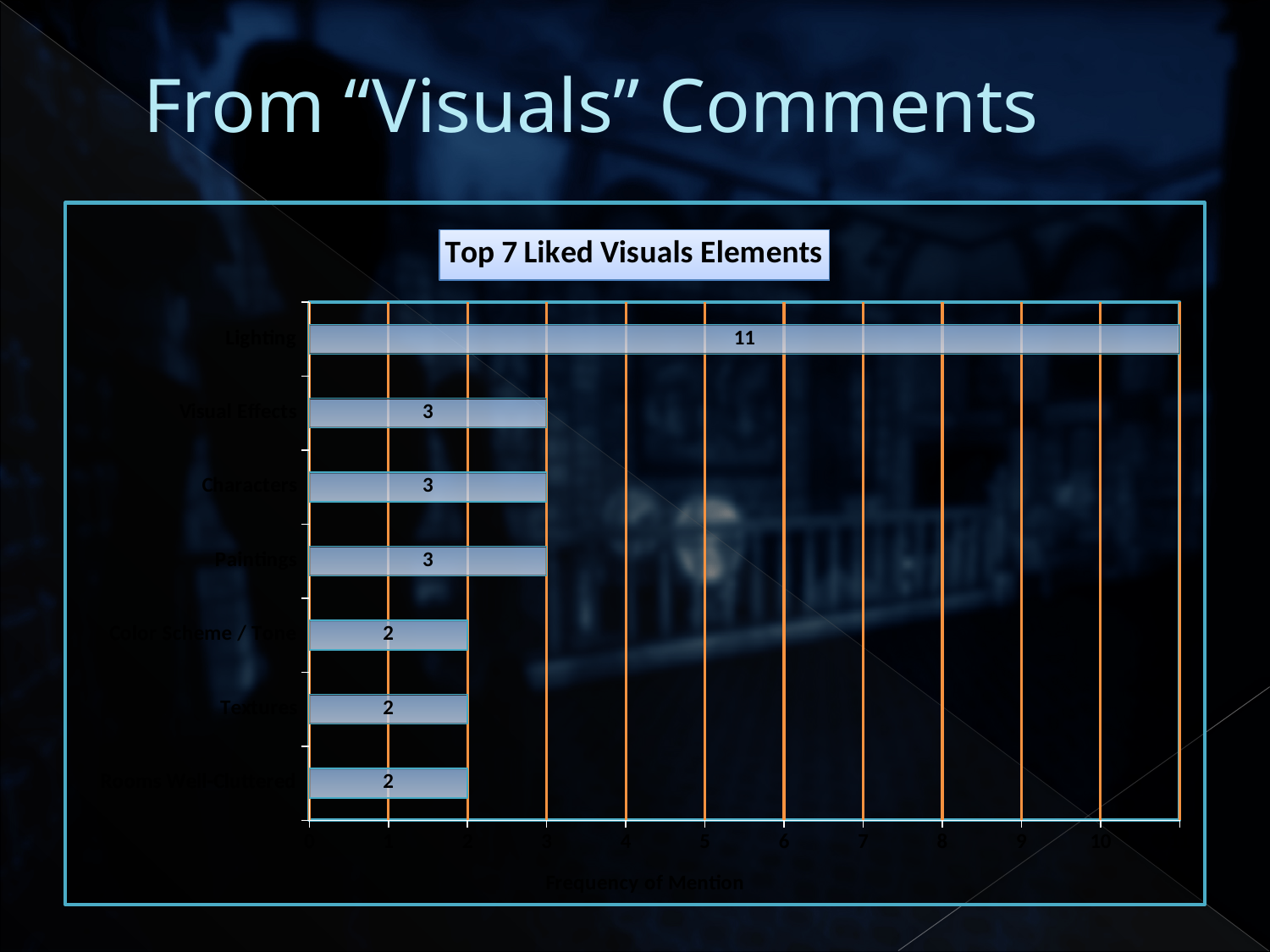
What is the value for Lighting? 11 What is the label of the horizontal axis? Frequency of Mention Which category has the highest frequency of mention? Lighting What is the title of the chart? Top 7 Liked Visuals Elements What is the value for Textures? 2 How many categories are shown in the chart? 7 Is the value for Lighting greater or less than 10? greater What kind of chart is shown on the slide? Bar chart Which is larger, the value for Visual Effects or the value for Color Scheme / Tone? Visual Effects What is the value for Visual Effects? 3 What is the value for Paintings? 3 What is the difference between the values for Lighting and Characters? 8